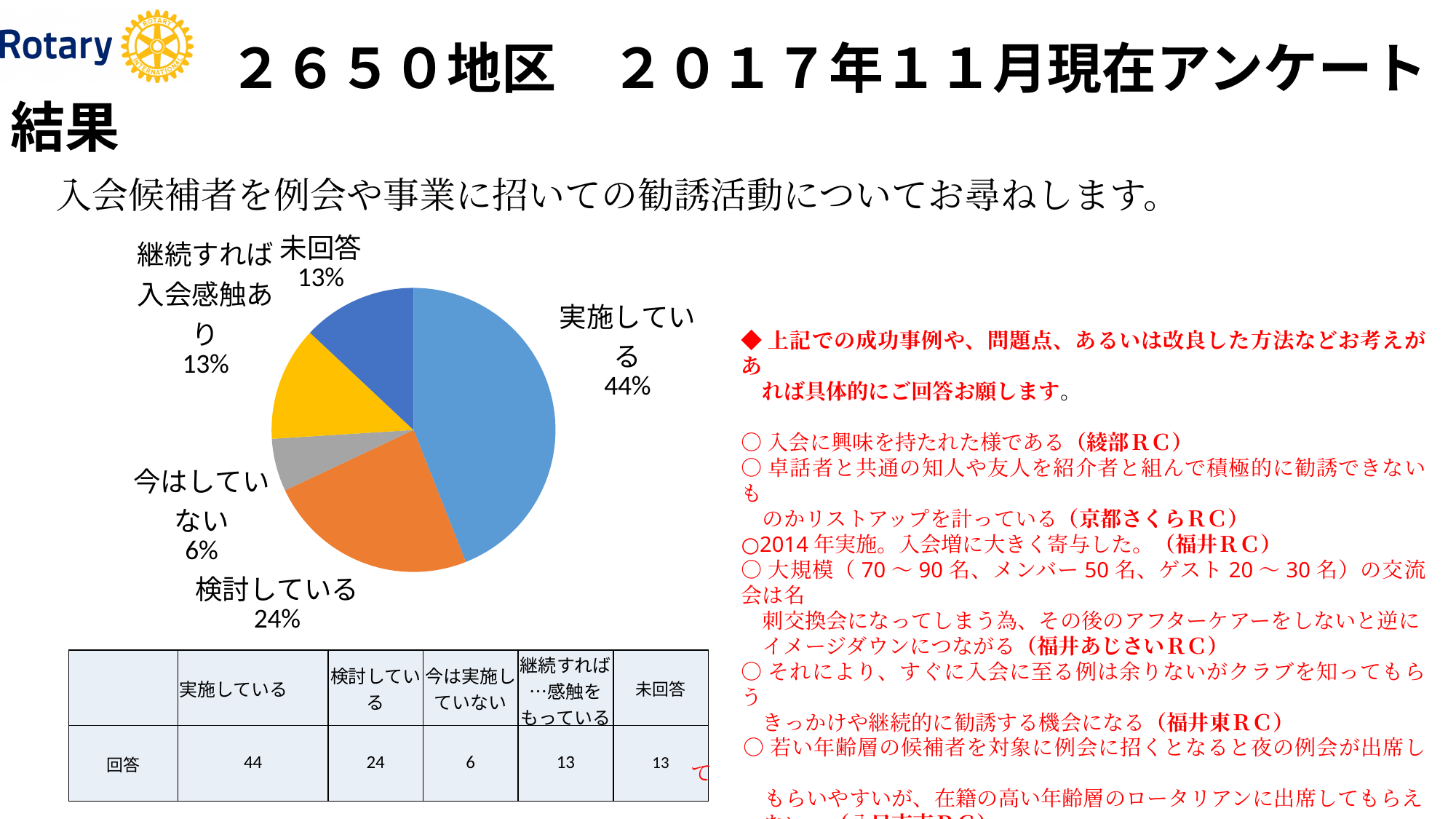
What percentage is shown for 今はしていない? 6% How many slices does the pie chart have? 5 Which category has the smallest slice of the pie chart? 今はしていない What percentage does the 検討している slice show? 24% What colour is the 実施している slice of the pie chart? Blue What share of the pie does 継続すれば入会感触あり represent? 13% What is the difference in percentage points between 実施している and 検討している? 20 Which is larger, the slice for 検討している or the slice for 今はしていない? 検討している Which category has the largest slice of the pie chart? 実施している What percentage is shown for 未回答? 13% What kind of chart is shown on the slide? Pie chart What percentage of the pie chart is labelled 実施している? 44%